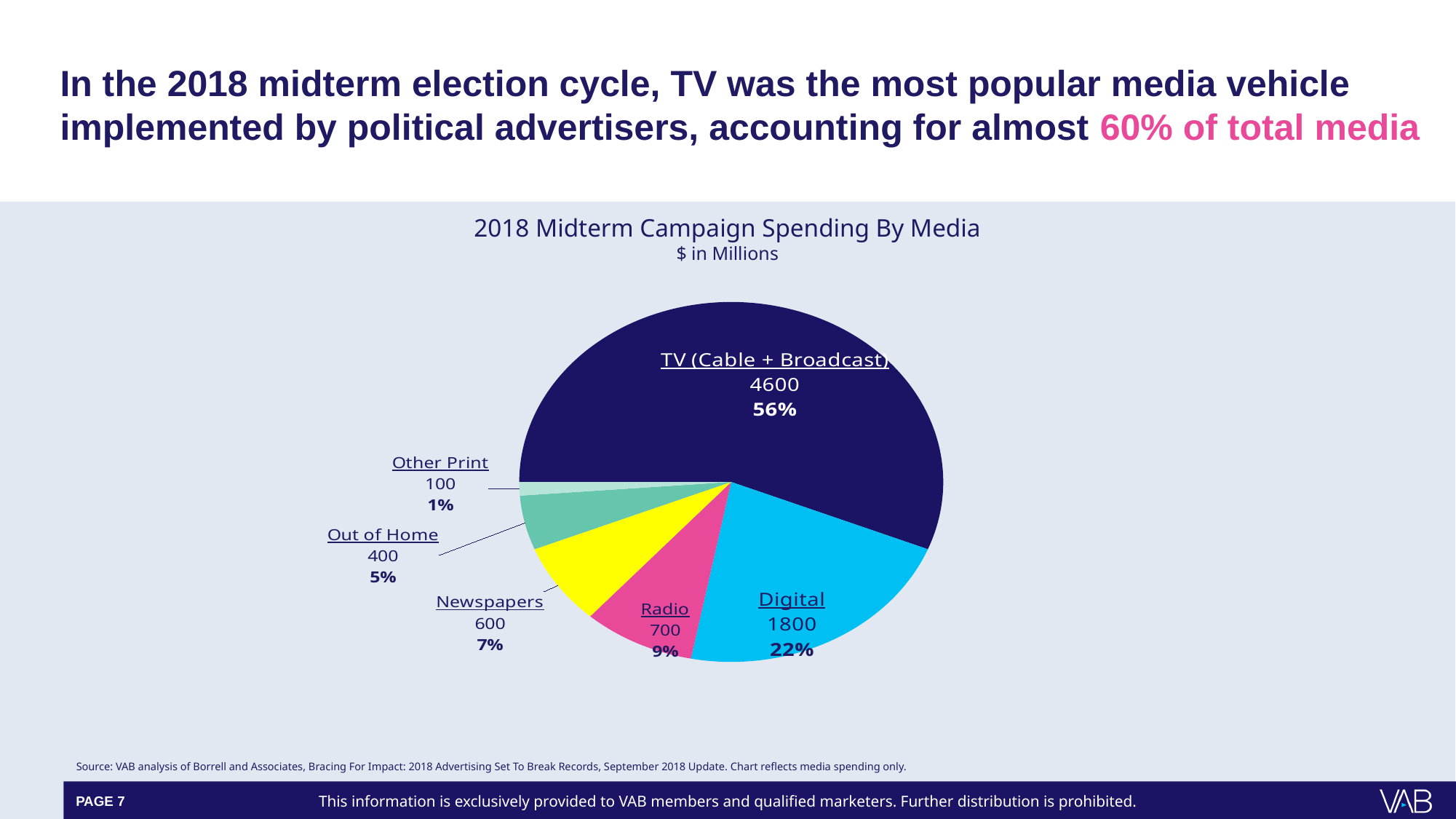
How many media categories are shown in the pie chart? 6 What is the difference in spending between TV (Cable + Broadcast) and Digital? 2800 What is the difference in spending between Newspapers and Out of Home? 200 What type of chart is shown on the slide? pie chart Which media category has the lowest spending? Other Print Which has higher spending, Newspapers or Radio? Radio What is the spending value for Digital? 1800 Which media category has the highest spending? TV (Cable + Broadcast) What is the spending value for Radio? 700 What share of the pie does TV (Cable + Broadcast) account for? 56% What is the title of the chart? 2018 Midterm Campaign Spending By Media What share of the pie does Out of Home account for? 5%